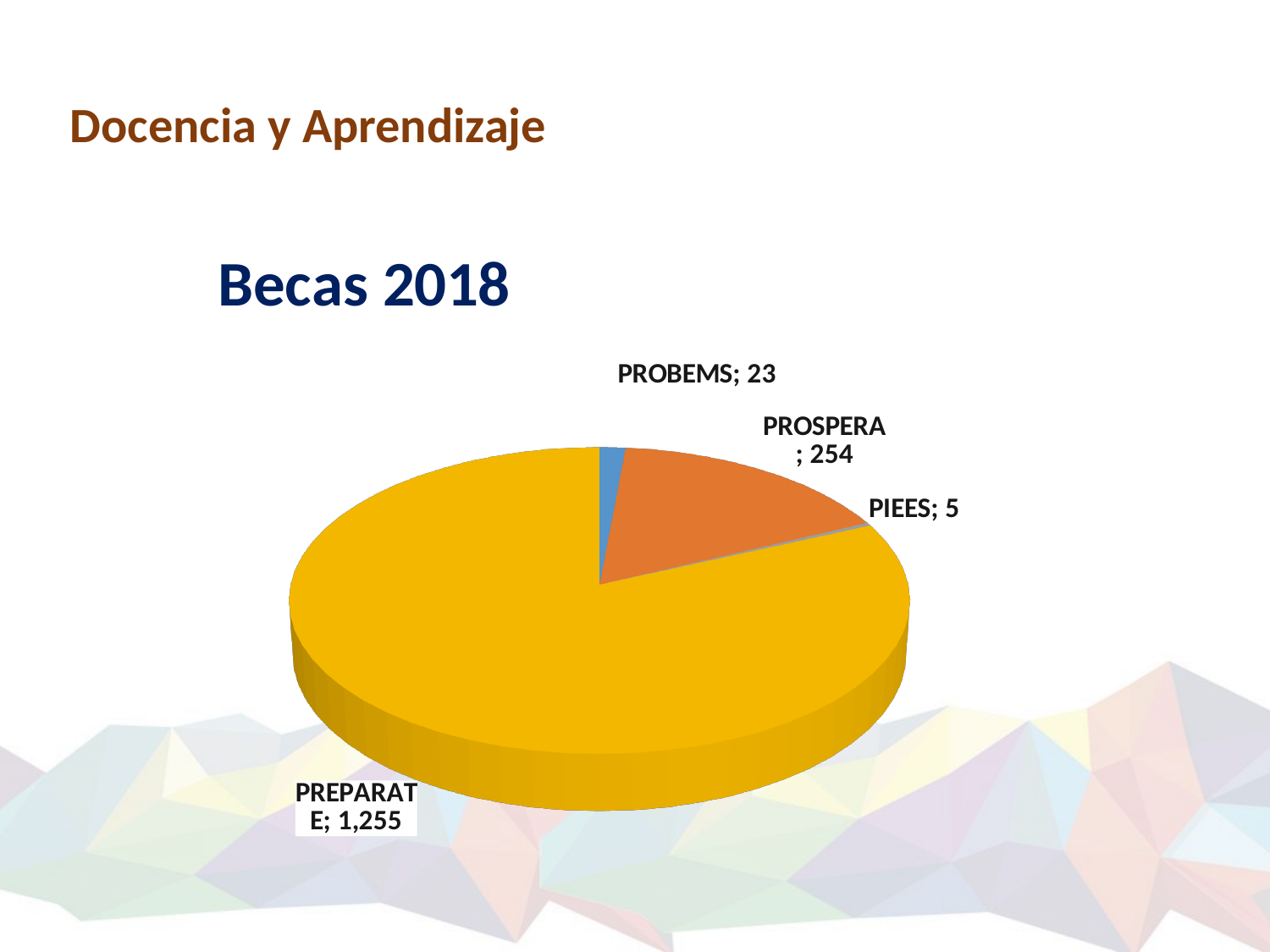
Which category has the largest slice? PREPARATE What is the value for PREPARATE? 1,255 What is the value for PROBEMS? 23 What is the value for PROSPERA? 254 How many slices does the pie chart have? 4 Which is larger, the value for PROSPERA or the value for PROBEMS? PROSPERA Which category has the smallest slice? PIEES What is the value for PIEES? 5 What kind of chart is shown on the slide? pie chart What is the title of the chart? Becas 2018 What is the total of all the slices in the pie chart? 1,537 What is the difference between the values for PREPARATE and PROSPERA? 1,001